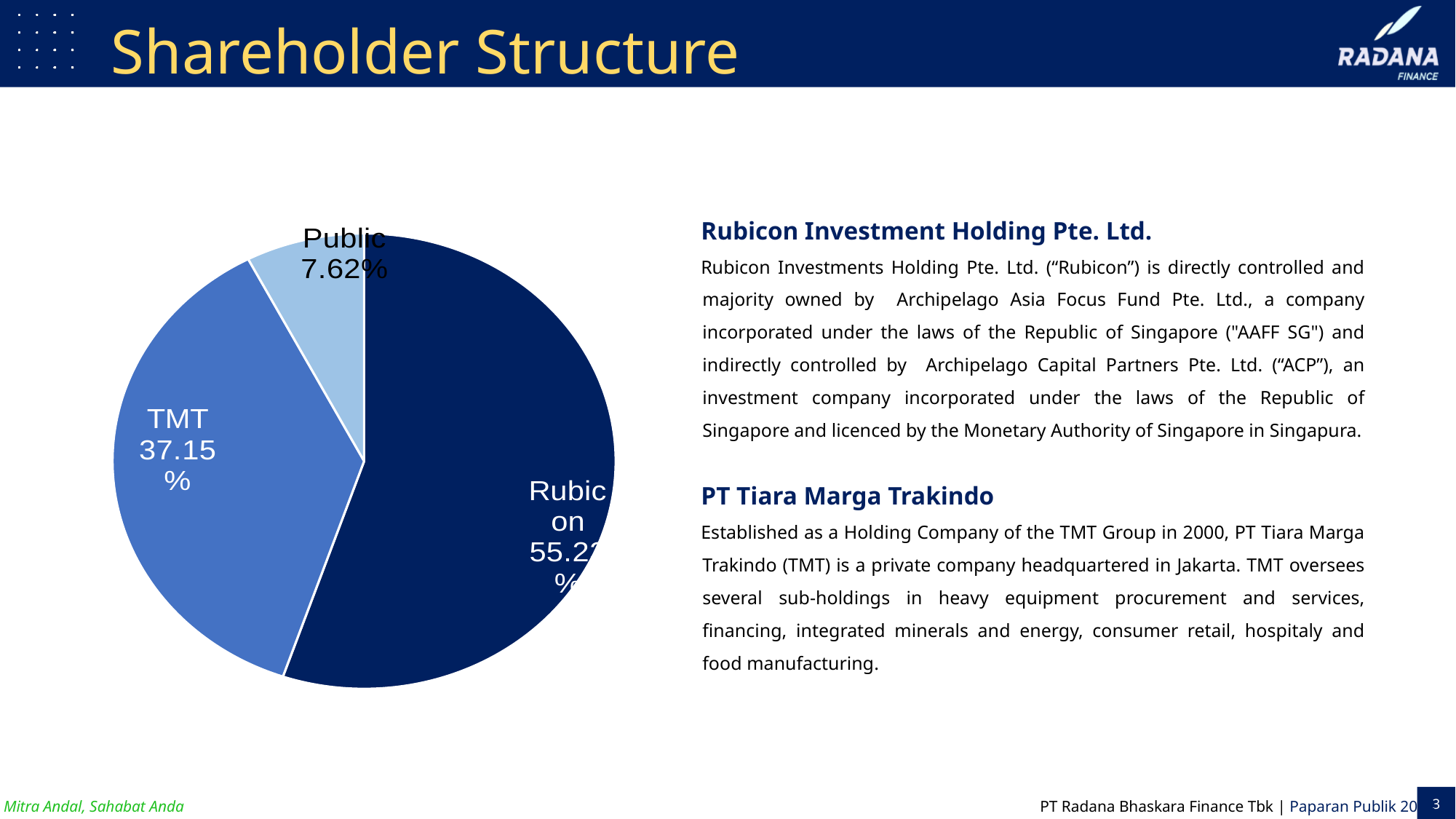
What is the title of the slide containing the pie chart? Shareholder Structure Which shareholder has the largest slice of the pie chart? Rubicon What is the difference in percentage points between the TMT share and the Public share? 29.53% How many slices does the pie chart have? 3 Which is larger in the pie chart, the TMT slice or the Public slice? TMT What type of chart is shown on the slide? pie chart Which slice of the pie chart is shown in the darkest blue colour? Rubicon What share of the pie chart does TMT hold? 37.15% Which shareholder has the smallest slice of the pie chart? Public Which is larger in the pie chart, the Rubicon slice or the TMT slice? Rubicon What share of the pie chart does Public hold? 7.62%